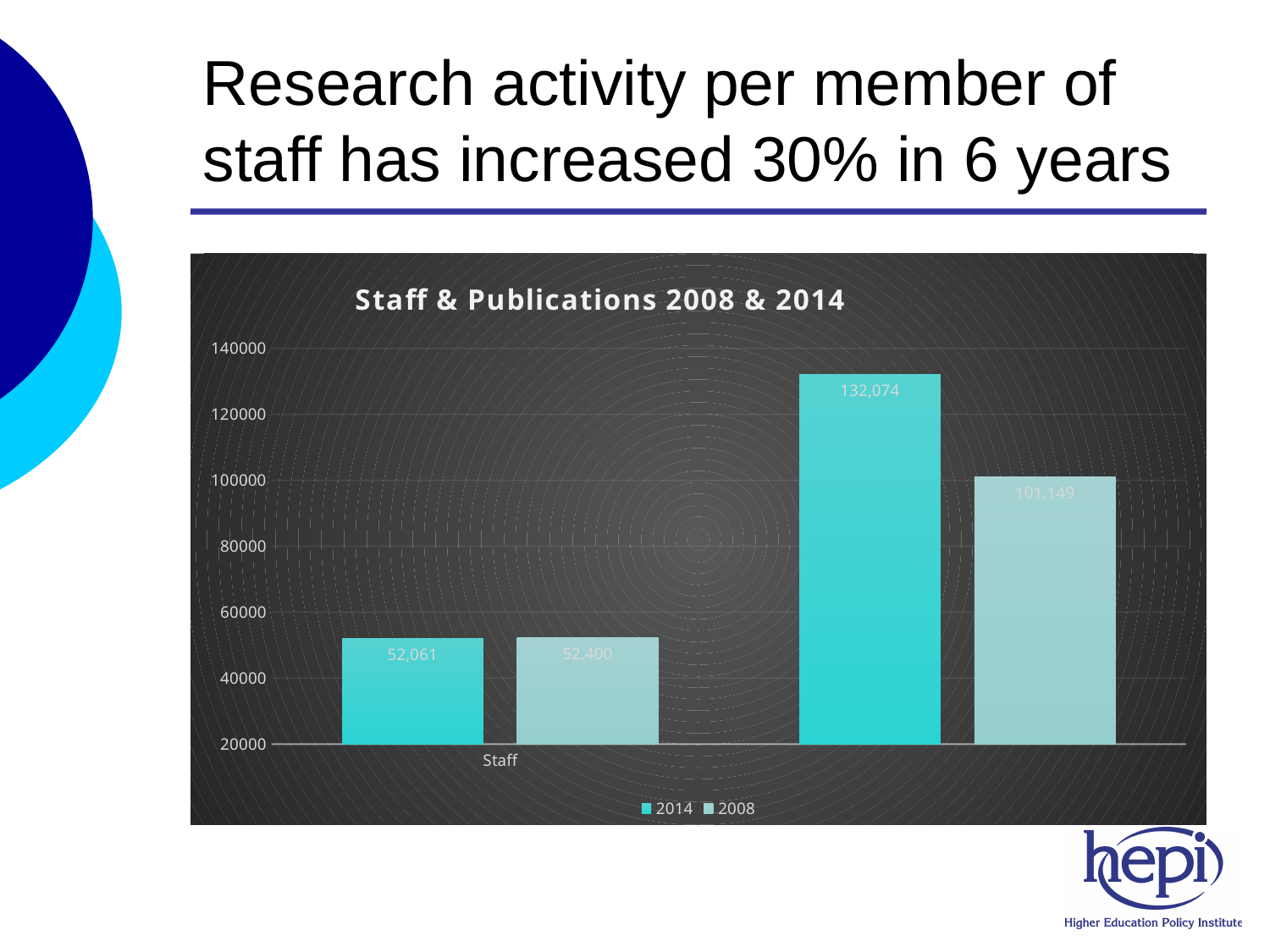
What are the two entries in the chart legend? 2014 and 2008 How many bars are plotted on the chart? 4 What is the value of the 2014 bar for Staff? 52,061 How many series does the legend list? 2 For Staff, which year has the larger value, 2014 or 2008? 2008 What kind of chart is shown on the slide? Bar chart Is the 2014 value for Staff greater or less than 60000? less What is the title of the chart? Staff & Publications 2008 & 2014 What is the highest value labelled on the chart? 132,074 What is the difference between the 2008 and 2014 values for Staff? 339 What is the value of the 2008 bar for Staff? 52,400 What is the lowest value labelled on the chart? 52,061